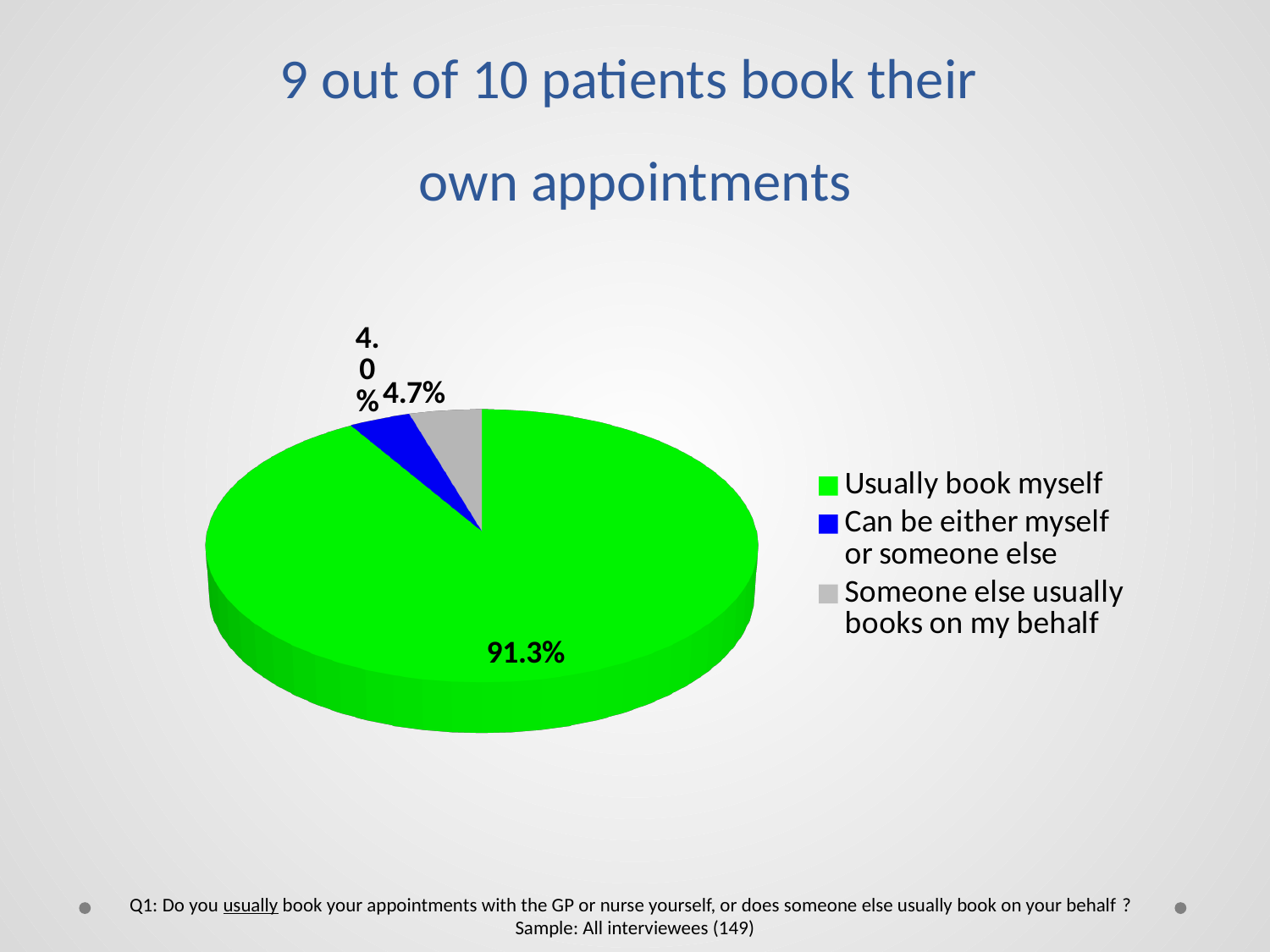
What is the title of the slide containing the chart? 9 out of 10 patients book their own appointments Which is larger: the share for 'Someone else usually books on my behalf' or the share for 'Can be either myself or someone else'? Someone else usually books on my behalf What percentage of patients say appointments can be booked by either themselves or someone else? 4.0% What colour is the slice for 'Usually book myself'? Green How many slices does the pie chart have? 3 How many entries does the legend list? 3 What percentage of patients say someone else usually books on their behalf? 4.7% Which category has the largest slice of the pie? Usually book myself What is the difference in percentage points between 'Usually book myself' and 'Someone else usually books on my behalf'? 86.6 What kind of chart is shown on the slide? Pie chart What share of patients say they usually book their own appointments? 91.3% Which category has the smallest slice of the pie? Can be either myself or someone else